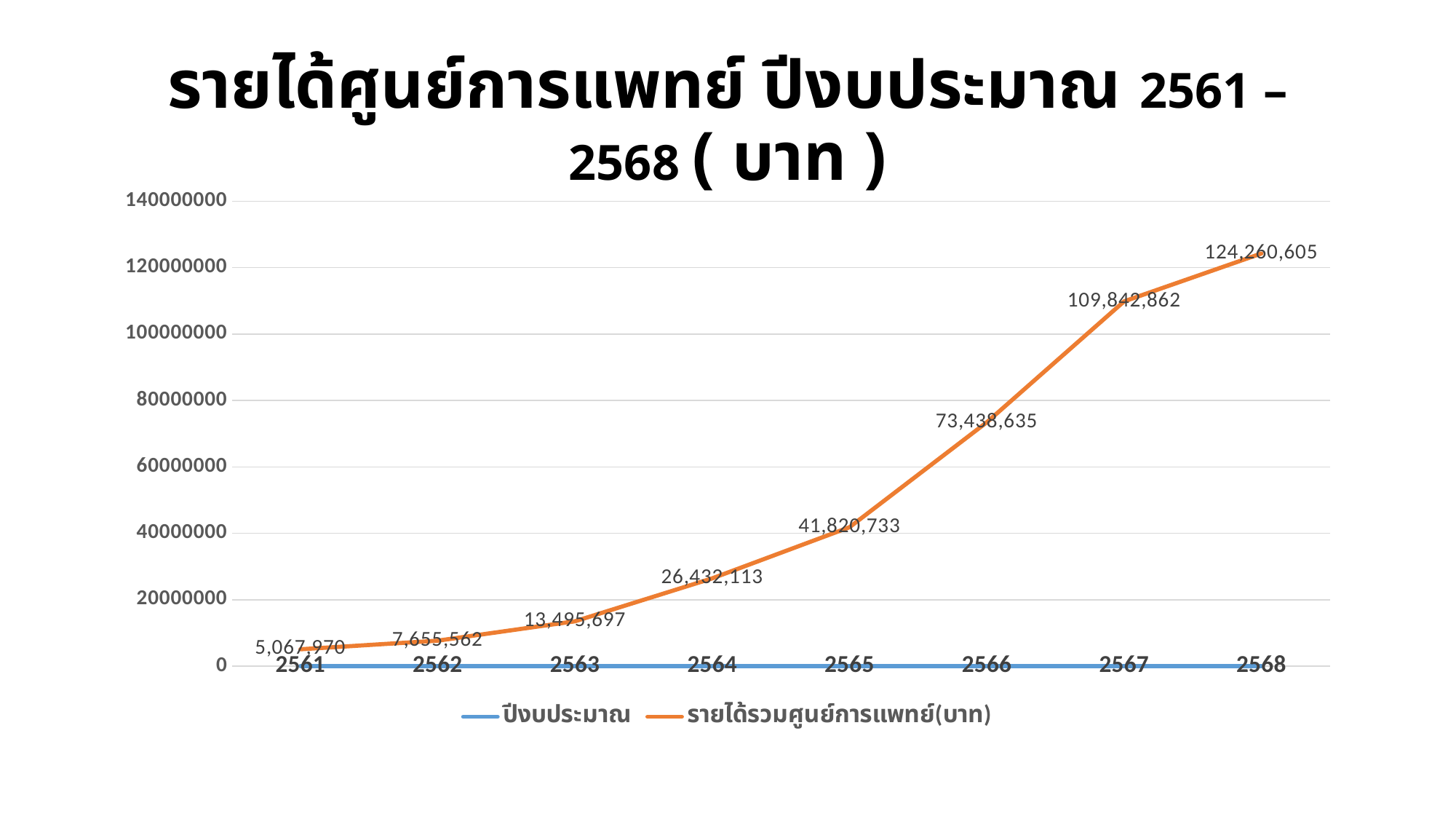
Which fiscal year has higher revenue, 2564 or 2566? 2566 Is the revenue for fiscal year 2567 greater or less than 100000000? greater What is the revenue (รายได้รวมศูนย์การแพทย์) for fiscal year 2568? 124,260,605 Which fiscal year has the highest revenue? 2568 What is the difference in revenue between fiscal years 2566 and 2565? 31,617,902 What kind of chart is shown on the slide? Line chart What is the revenue (รายได้รวมศูนย์การแพทย์) for fiscal year 2561? 5,067,970 How many fiscal years are plotted on the x axis? 8 What is the difference in revenue between fiscal years 2568 and 2567? 14,417,743 What is the revenue (รายได้รวมศูนย์การแพทย์) for fiscal year 2565? 41,820,733 Which fiscal year has the lowest revenue? 2561 How many series does the legend list? 2